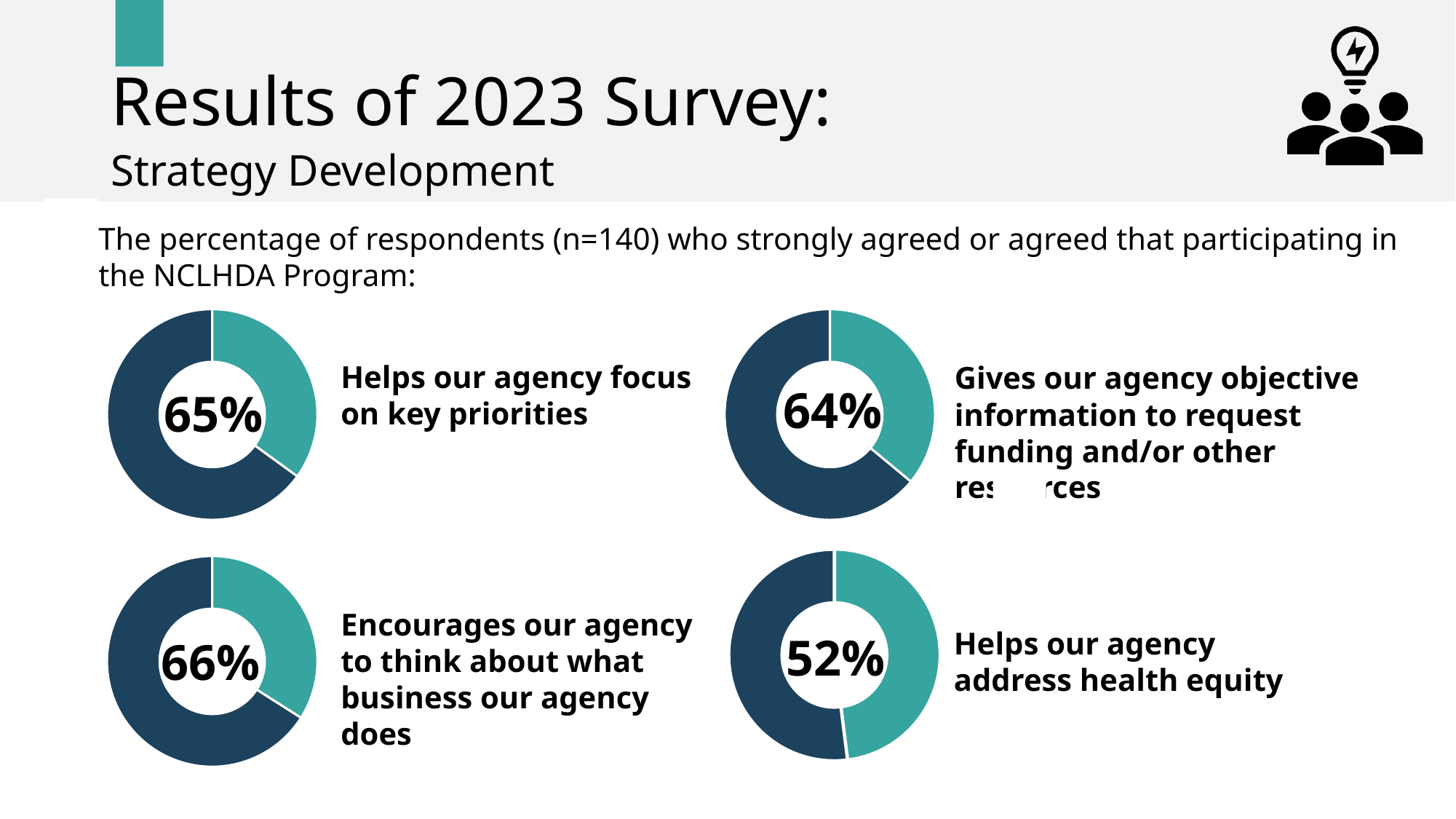
What is the difference in percentage points between 'Helps our agency focus on key priorities' and 'Gives our agency objective information to request funding and/or other resources'? 1 What percentage of respondents agreed that the program encourages their agency to think about what business their agency does? 66% How many donut charts are shown on the slide? 4 Which statement received the highest percentage of agreement on the slide? Encourages our agency to think about what business our agency does What percentage of respondents agreed that participating in the NCLHDA Program helps their agency focus on key priorities? 65% Which has a higher percentage: 'Helps our agency focus on key priorities' or 'Helps our agency address health equity'? Helps our agency focus on key priorities Which statement received the lowest percentage of agreement on the slide? Helps our agency address health equity What percentage of respondents agreed that the program gives their agency objective information to request funding and/or other resources? 64% What kind of chart is used to display each percentage on the slide? Donut chart What percentage of respondents agreed that the program helps their agency address health equity? 52% How many respondents (n) does the slide say took the survey? 140 What is the difference in percentage points between the 'Encourages our agency to think about what business our agency does' chart and the 'Helps our agency address health equity' chart? 14